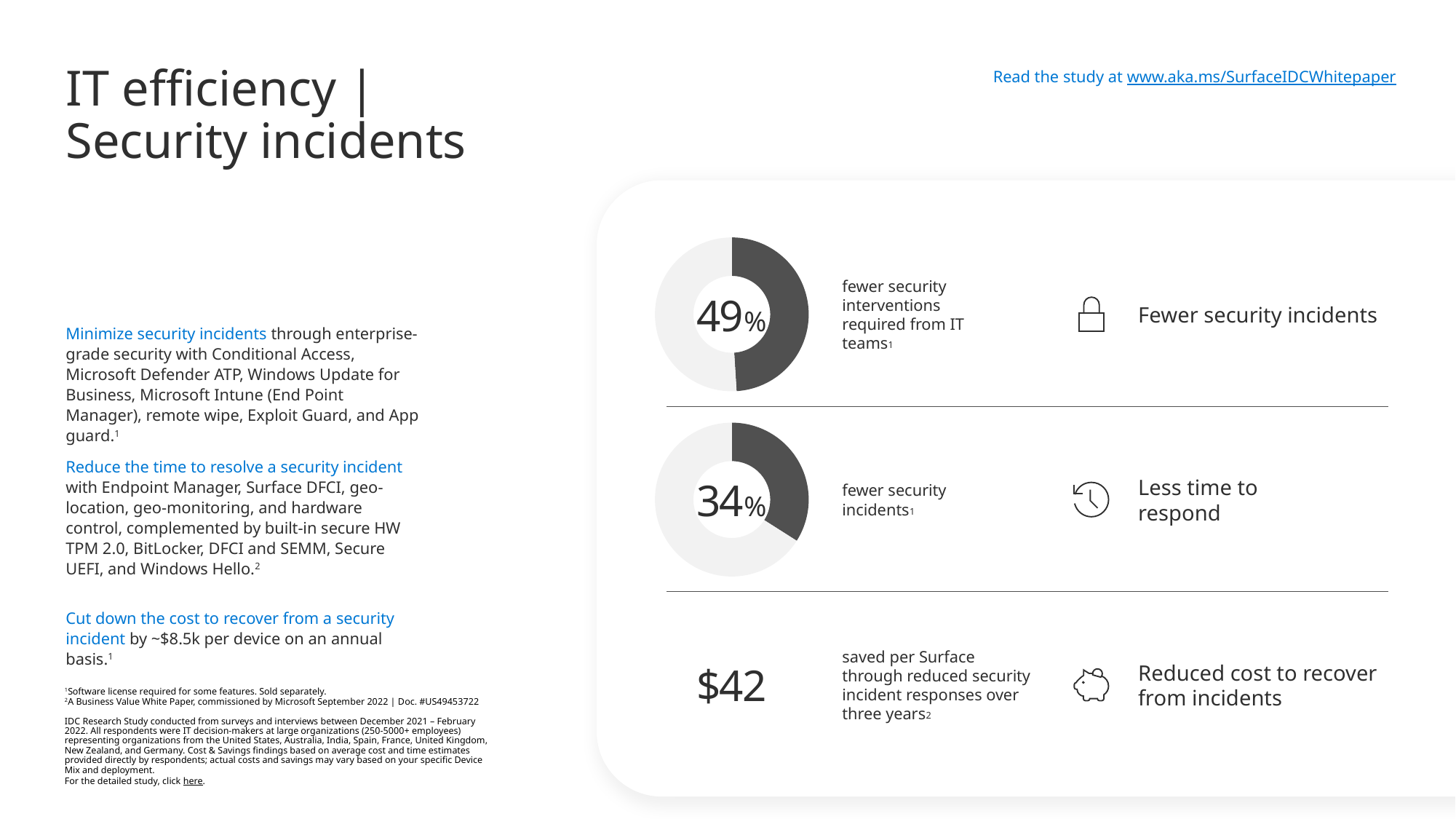
What share of the lower donut chart is filled by the dark segment? 34% What share of the top donut chart is filled by the dark segment? 49% What label accompanies the lower donut chart showing 34%? fewer security incidents What is the difference in percentage points between the top donut chart (49%) and the lower donut chart (34%)? 15 percentage points Is the value in the lower donut chart greater or less than 25%? greater Which donut chart shows the larger percentage, the one for fewer security interventions or the one for fewer security incidents? Fewer security interventions (49%) What percentage is shown in the lower donut chart, for fewer security incidents? 34% How many donut charts are on the slide? 2 What percentage is shown in the top donut chart, for fewer security interventions required from IT teams? 49% What colour is the filled segment in the donut charts? Dark grey What kind of chart is used to show the 49% and 34% figures? Donut chart Is the value in the top donut chart greater or less than 50%? less